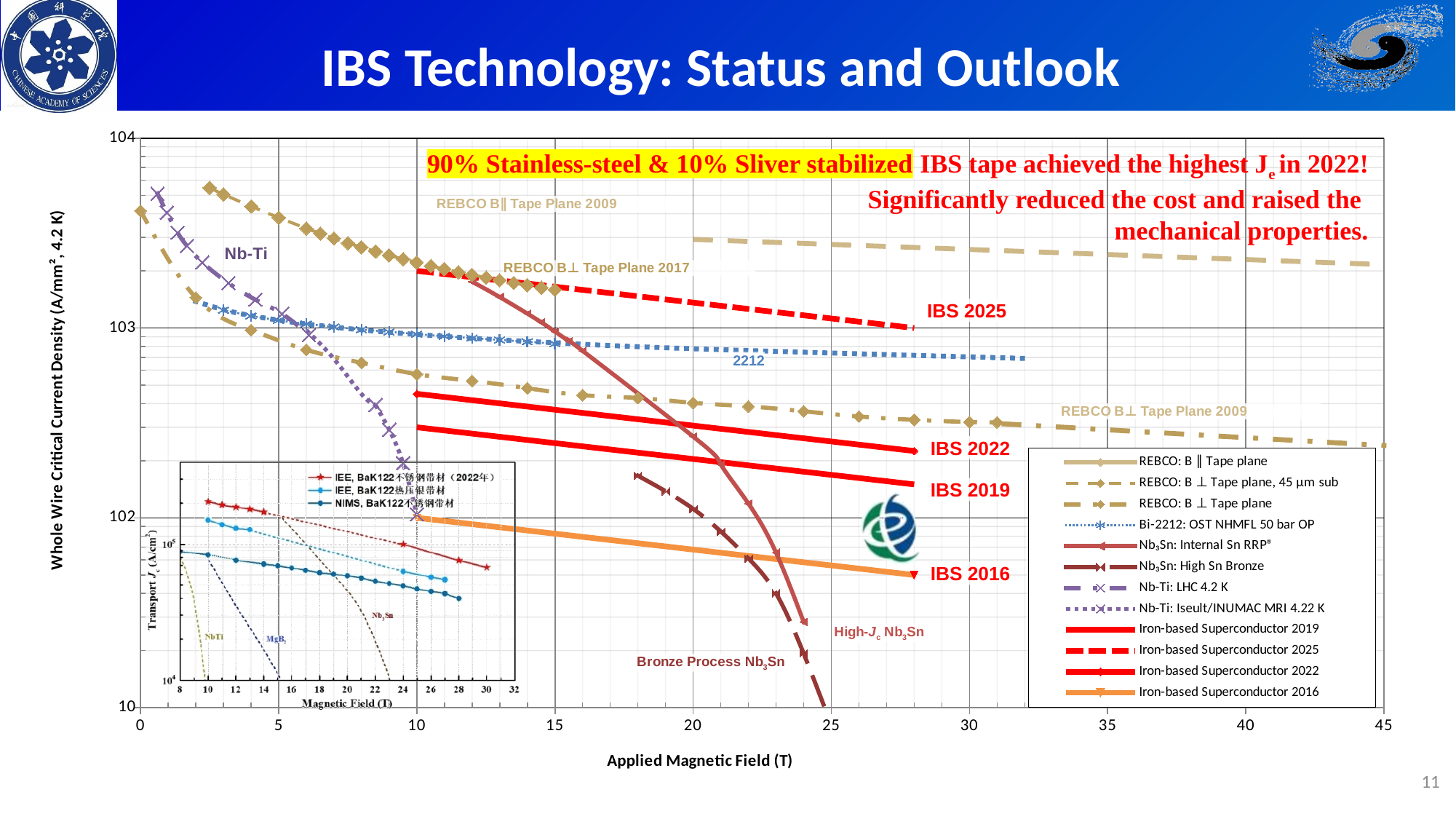
Is the value of the IBS 2016 line at 28 T greater or less than 10³ A/mm²? less Is the value of the IBS 2025 line at 15 T greater or less than 10³ A/mm²? greater At 20 T, which line is higher: IBS 2025 or IBS 2022? IBS 2025 At 25 T, which line is higher: IBS 2022 or IBS 2019? IBS 2022 What is the title of the y axis of the main chart? Whole Wire Critical Current Density (A/mm², 4.2 K) What kind of chart is the main chart on the slide? line chart Which series is the highest on the chart at 40 T? REBCO: B ∥ Tape plane How many series does the legend of the main chart list? 12 Which of the four Iron-based Superconductor lines is the lowest on the chart? Iron-based Superconductor 2016 What is the maximum value shown on the x axis of the main chart? 45 What is the title of the x axis of the main chart? Applied Magnetic Field (T) Does the IBS 2022 line rise or fall as the applied magnetic field increases? fall